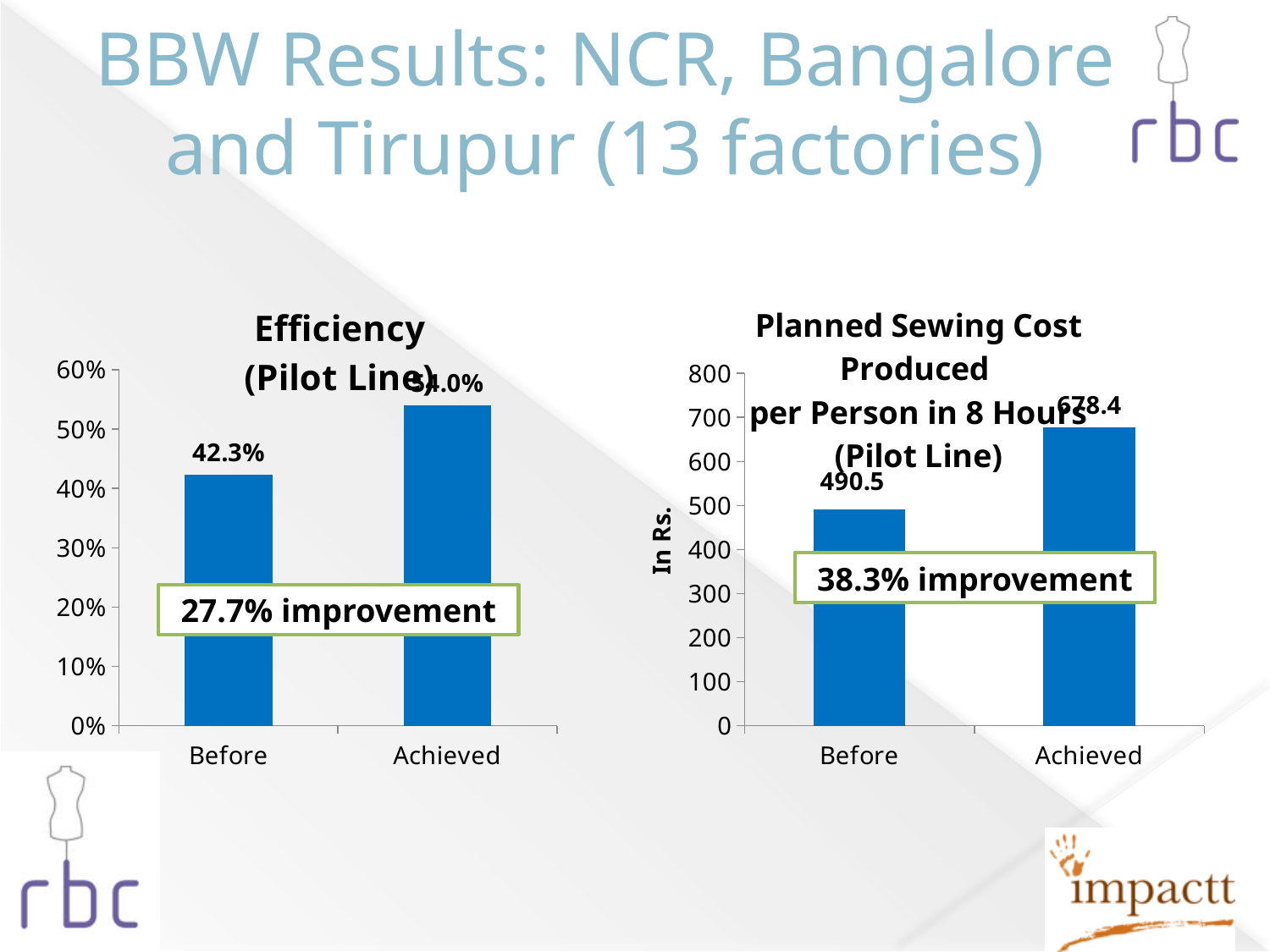
In the Planned Sewing Cost Produced per Person in 8 Hours chart, which category has the lowest value? Before What kind of chart is the Efficiency (Pilot Line) chart? Bar chart What is the y-axis label on the Planned Sewing Cost Produced per Person in 8 Hours chart? In Rs. In the Planned Sewing Cost Produced per Person in 8 Hours chart, is the value for Achieved greater or less than 600? greater In the Efficiency (Pilot Line) chart, is the value for Achieved greater or less than 50%? greater In the Efficiency (Pilot Line) chart, what is the value for Before? 42.3% In the Efficiency (Pilot Line) chart, which category has the higher value, Before or Achieved? Achieved How many categories are shown in the Planned Sewing Cost Produced per Person in 8 Hours chart? 2 In the Efficiency (Pilot Line) chart, which category has the highest value? Achieved In the Planned Sewing Cost Produced per Person in 8 Hours chart, what is the value for Before? 490.5 What improvement percentage is stated in the box on the Efficiency (Pilot Line) chart? 27.7% improvement In the Planned Sewing Cost Produced per Person in 8 Hours chart, do the values rise or fall from Before to Achieved? Rise